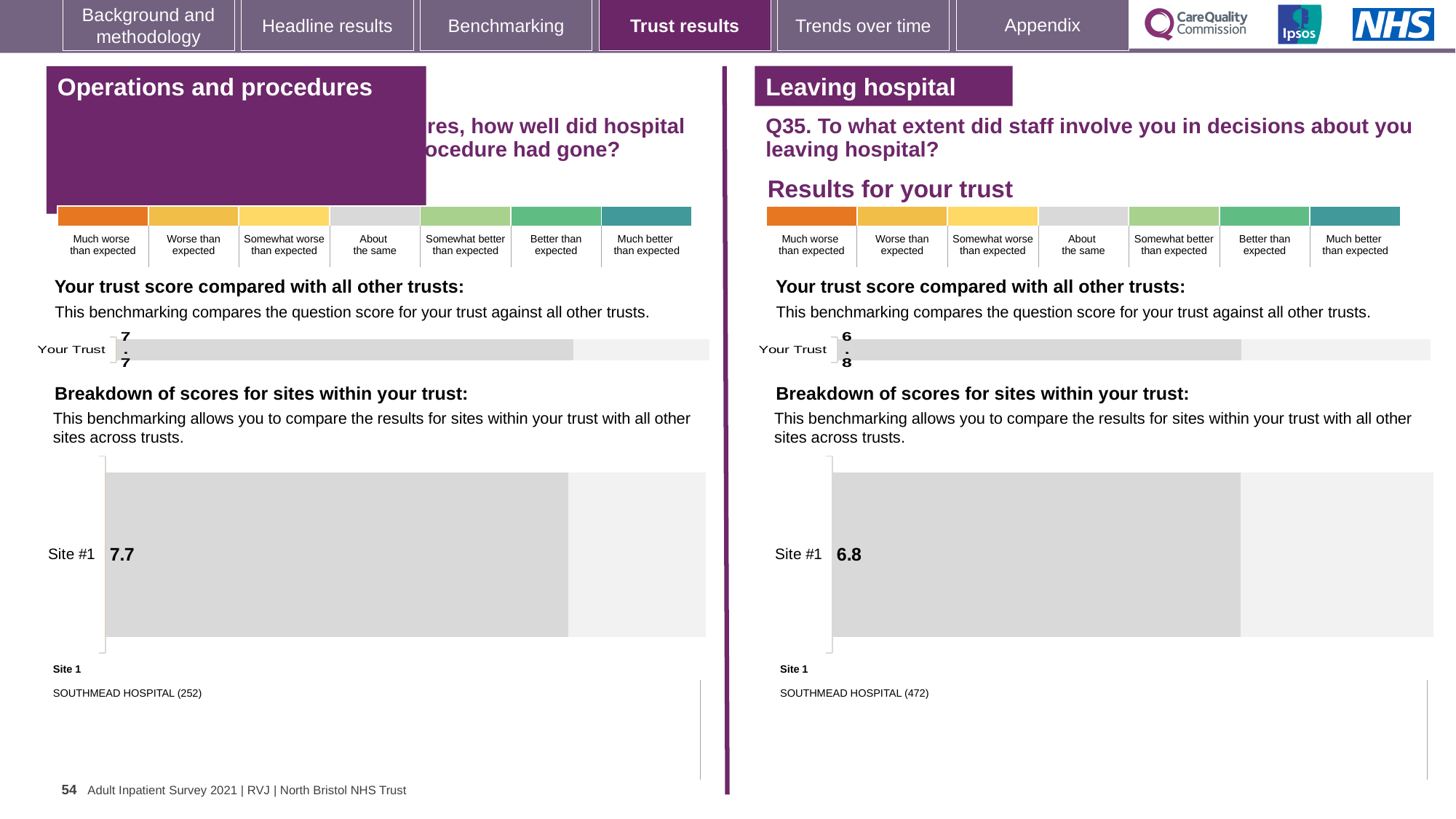
In the Operations and procedures section, what score is shown for Site #1 in the breakdown of scores for sites chart? 7.7 In the Leaving hospital section, what is the score shown for Your Trust in the 'Your trust score compared with all other trusts' chart? 6.8 How many sites are shown in the breakdown of scores for sites chart in the Operations and procedures section? 1 What is the difference between the Site #1 score in the Operations and procedures section and the Site #1 score in the Leaving hospital section? 0.9 In the Leaving hospital section, what score is shown for Site #1 in the breakdown of scores for sites chart? 6.8 How many sites are shown in the breakdown of scores for sites chart in the Leaving hospital section? 1 In the Leaving hospital section, which hospital is listed as Site 1 below the site breakdown chart? SOUTHMEAD HOSPITAL (472) In the Operations and procedures section, which hospital is listed as Site 1 below the site breakdown chart? SOUTHMEAD HOSPITAL (252) In the Operations and procedures section, what is the score shown for Your Trust in the 'Your trust score compared with all other trusts' chart? 7.7 What type of chart is used to show the Site #1 score in the Leaving hospital section? Bar chart Which is larger: the Your Trust score in the Operations and procedures section or the Your Trust score in the Leaving hospital section? Operations and procedures